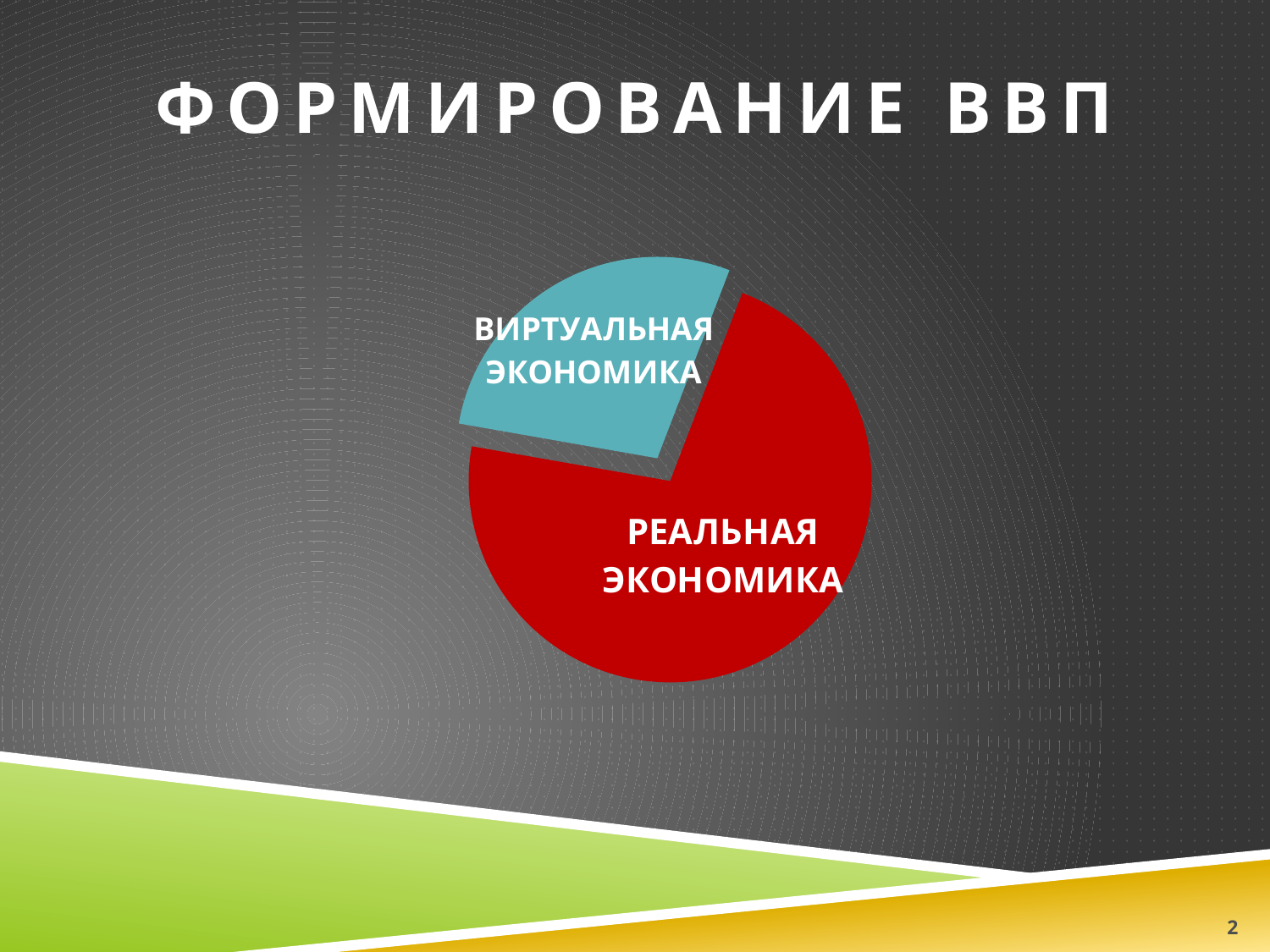
What kind of chart is shown on the slide? pie chart What is the title of the slide containing the pie chart? ФОРМИРОВАНИЕ ВВП Which is larger in the pie chart, ВИРТУАЛЬНАЯ ЭКОНОМИКА or РЕАЛЬНАЯ ЭКОНОМИКА? РЕАЛЬНАЯ ЭКОНОМИКА Which slice of the pie chart is the smallest? ВИРТУАЛЬНАЯ ЭКОНОМИКА Does the РЕАЛЬНАЯ ЭКОНОМИКА slice take up more or less than half of the pie? more How many slices does the pie chart have? 2 Which slice of the pie chart is the largest? РЕАЛЬНАЯ ЭКОНОМИКА What colour is the ВИРТУАЛЬНАЯ ЭКОНОМИКА slice of the pie chart? blue